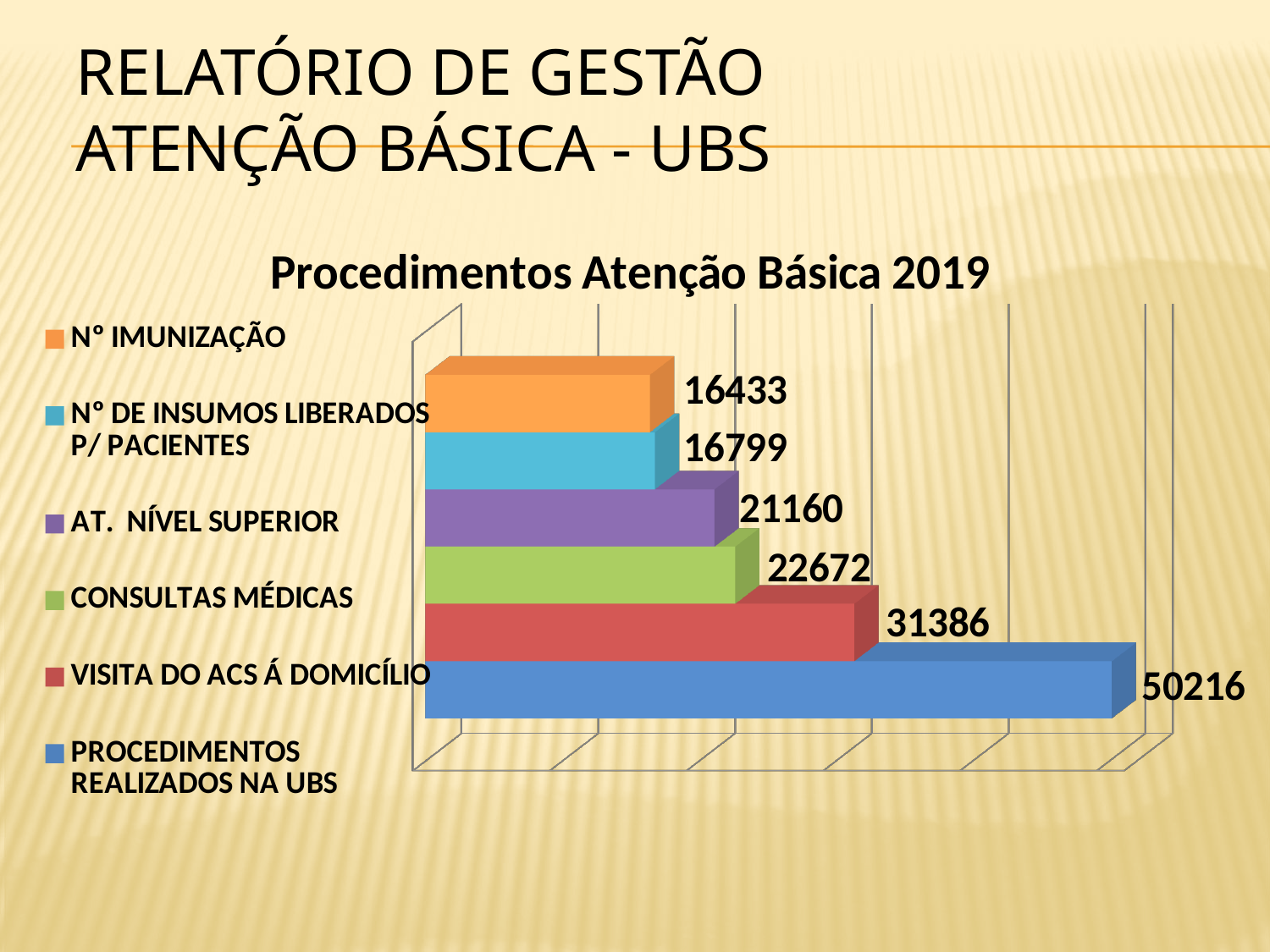
What is the value for VISITA DO ACS Á DOMICÍLIO? 31386 What is the value for Nº IMUNIZAÇÃO? 16433 What is the value for PROCEDIMENTOS REALIZADOS NA UBS? 50216 What is the title of the chart? Procedimentos Atenção Básica 2019 What kind of chart is shown? Bar chart What is the difference between PROCEDIMENTOS REALIZADOS NA UBS and VISITA DO ACS Á DOMICÍLIO? 18830 Which category has the highest value? PROCEDIMENTOS REALIZADOS NA UBS What is the difference between CONSULTAS MÉDICAS and AT. NÍVEL SUPERIOR? 1512 How many series does the legend list? 6 What is the value for CONSULTAS MÉDICAS? 22672 Which is larger, AT. NÍVEL SUPERIOR or Nº DE INSUMOS LIBERADOS P/ PACIENTES? AT. NÍVEL SUPERIOR Which category has the lowest value? Nº IMUNIZAÇÃO